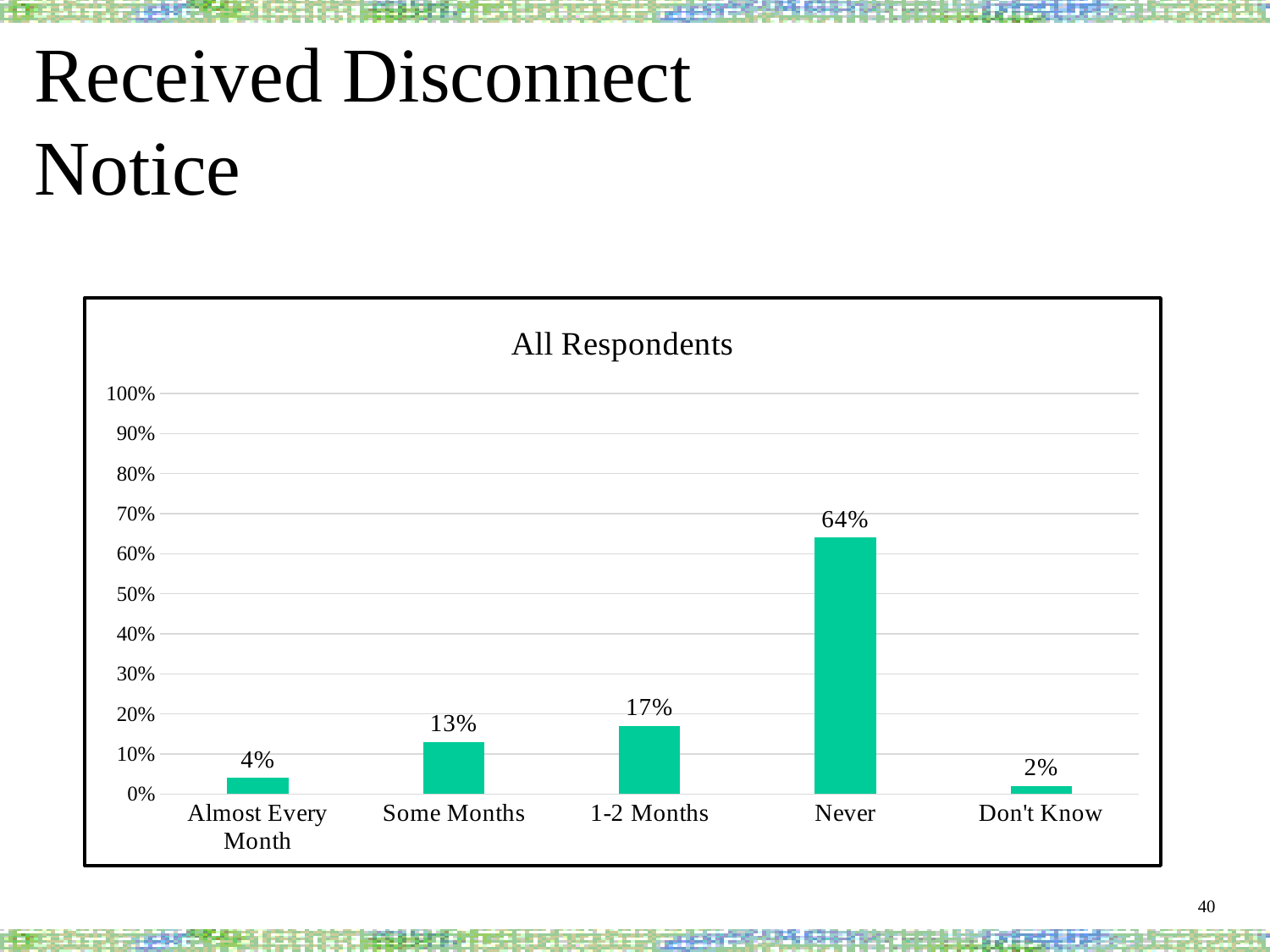
What is the value for "Almost Every Month"? 4% Is the value for "Never" greater or less than 50%? greater What is the difference between the values for "Some Months" and "Almost Every Month"? 9% What is the title of the chart? All Respondents What is the value for "Some Months"? 13% What percentage of respondents answered "Never"? 64% What is the difference between the values for "Never" and "1-2 Months"? 47% Which category has the highest value? Never How many categories are shown on the x axis? 5 Which category has the lowest value? Don't Know Which is larger, the value for "Some Months" or "1-2 Months"? 1-2 Months What kind of chart is shown on the slide? bar chart